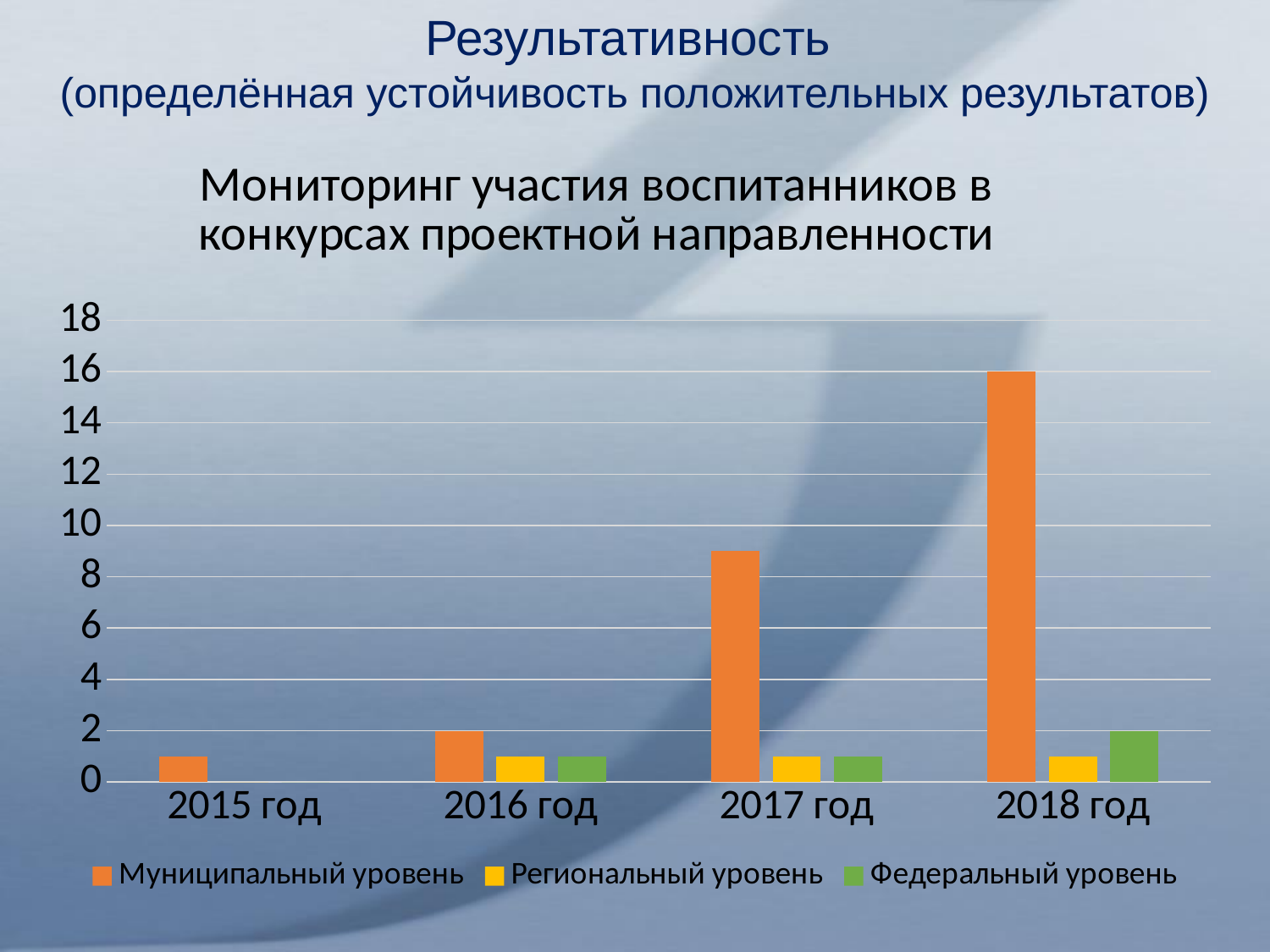
What is the value for Муниципальный уровень in 2018 год? 16 How many series does the legend list? 3 Do the Муниципальный уровень values rise or fall from 2015 год to 2018 год? rise What is the value for Федеральный уровень in 2018 год? 2 In which year is the Муниципальный уровень value lowest? 2015 год Which is larger: Муниципальный уровень in 2017 год or in 2018 год? 2018 год How many year categories are shown on the x axis? 4 What is the value for Муниципальный уровень in 2016 год? 2 In which year is the Муниципальный уровень value highest? 2018 год What is the difference between the Муниципальный уровень values for 2018 год and 2016 год? 14 Is the value for Муниципальный уровень in 2017 год greater or less than 8? greater What kind of chart is shown on the slide? bar chart